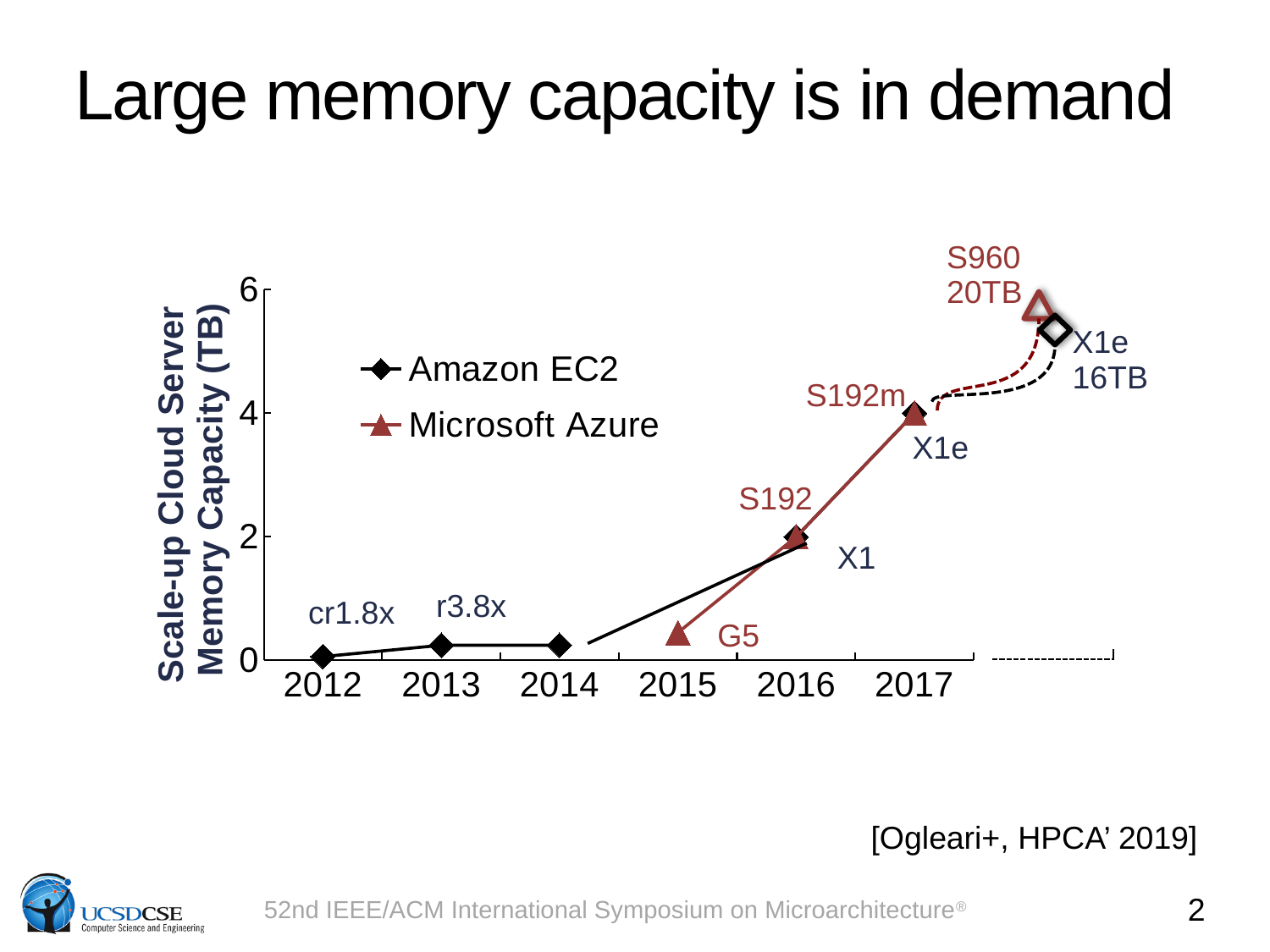
Is the Microsoft Azure value for 2015 (G5) greater or less than 2? less Which series is drawn with red triangle markers? Microsoft Azure What memory capacity is labeled for the S960 server? 20TB What is the difference between the labeled capacities of the S960 (20TB) and the rightmost X1e (16TB)? 4TB Do the memory capacity values rise or fall from 2012 to 2017? rise What are the two series named in the legend? Amazon EC2 and Microsoft Azure How many year labels are shown on the x axis? 6 Is the Amazon EC2 value for 2012 (cr1.8x) greater or less than 2? less What kind of chart is shown on the slide? line chart Which has the larger labeled capacity, the S960 or the rightmost X1e? S960 What memory capacity is labeled for the rightmost X1e point? 16TB How many series does the legend list? 2